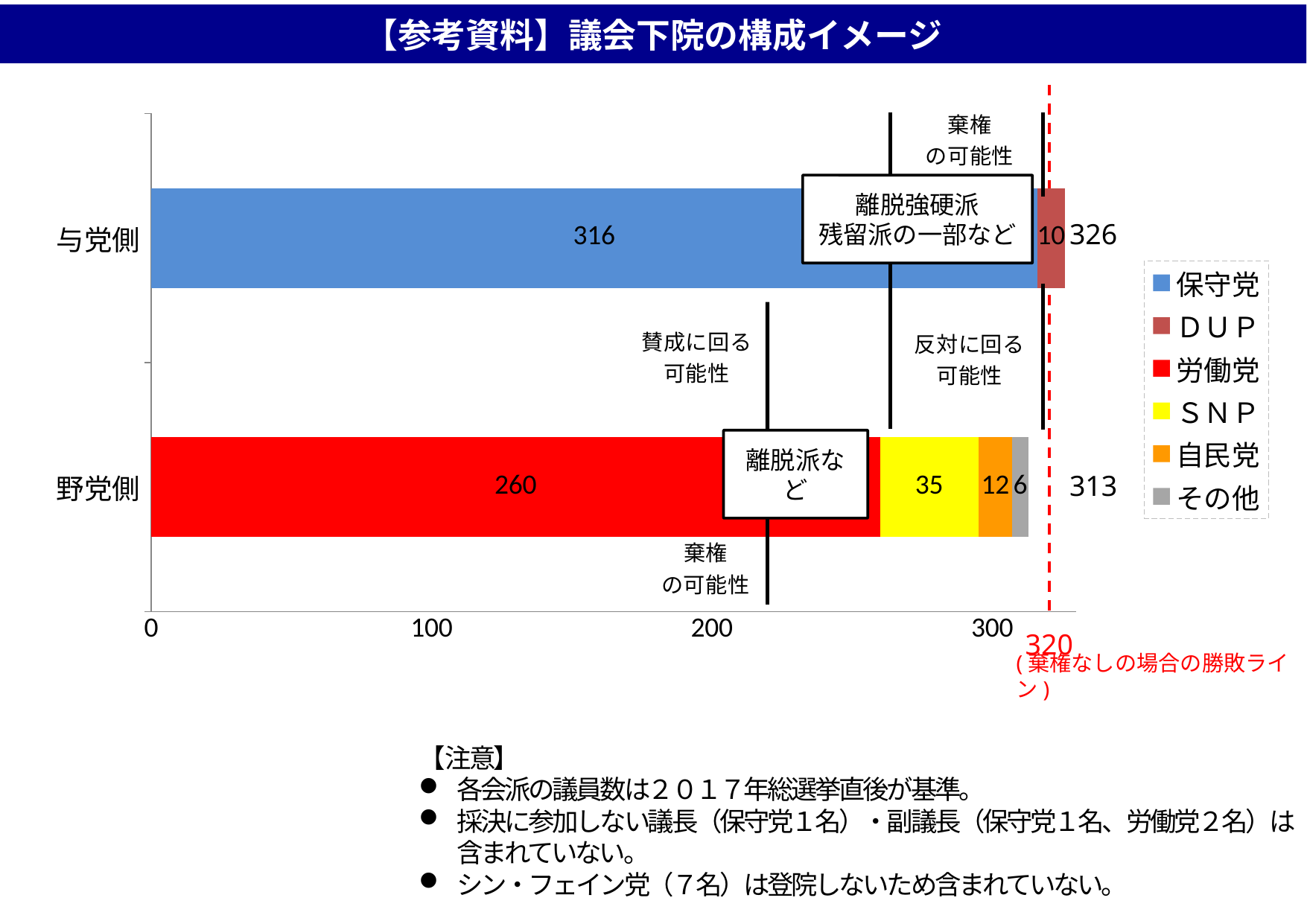
What is the total of the 野党側 stacked bar? 313 How many categories are plotted on the vertical axis? 2 What is the difference between the 保守党 value (316) and the 労働党 value (260)? 56 What is the value for ＤＵＰ in the 与党側 bar? 10 What kind of chart is shown on the slide? bar chart What is the total of the 与党側 stacked bar? 326 Which series is shown in yellow in the legend? ＳＮＰ What is the value for ＳＮＰ in the 野党側 bar? 35 How many series does the legend list? 6 What is the value for 労働党 in the 野党側 bar? 260 What is the value for 保守党 in the 与党側 bar? 316 What is the value for 自民党 in the 野党側 bar? 12